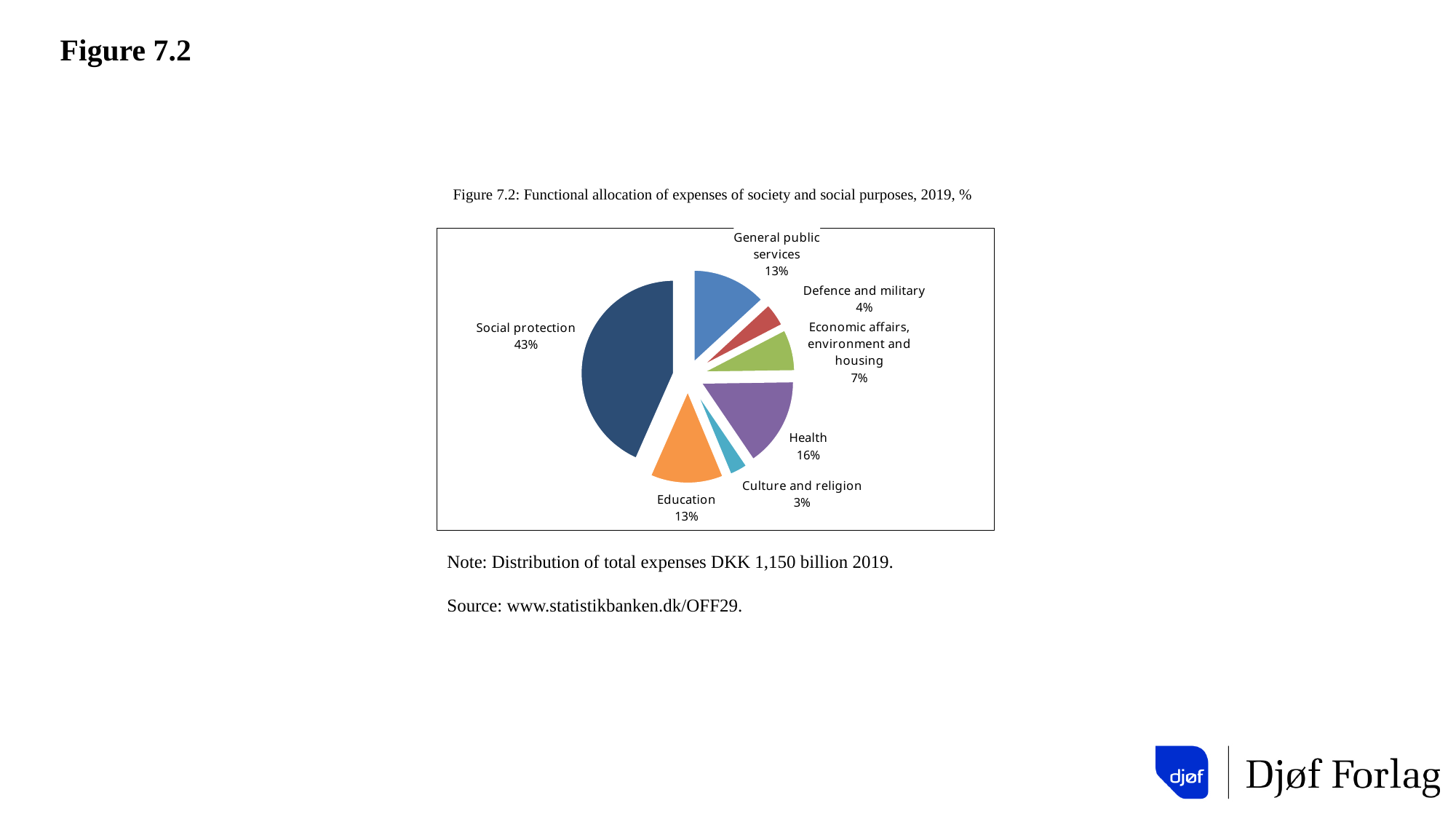
Which category has the smallest share of expenses? Culture and religion How many categories are shown in the pie chart? 7 What share of expenses goes to Culture and religion? 3% What kind of chart is shown on the slide? Pie chart Which has a larger share, Health or Education? Health Which category has the largest share of expenses? Social protection What share of expenses goes to Defence and military? 4% What is the title of the chart? Figure 7.2: Functional allocation of expenses of society and social purposes, 2019, % What is the difference in percentage points between Social protection and Health? 27 What share of expenses goes to Social protection? 43% What share of expenses goes to Health? 16% What share of expenses goes to Economic affairs, environment and housing? 7%